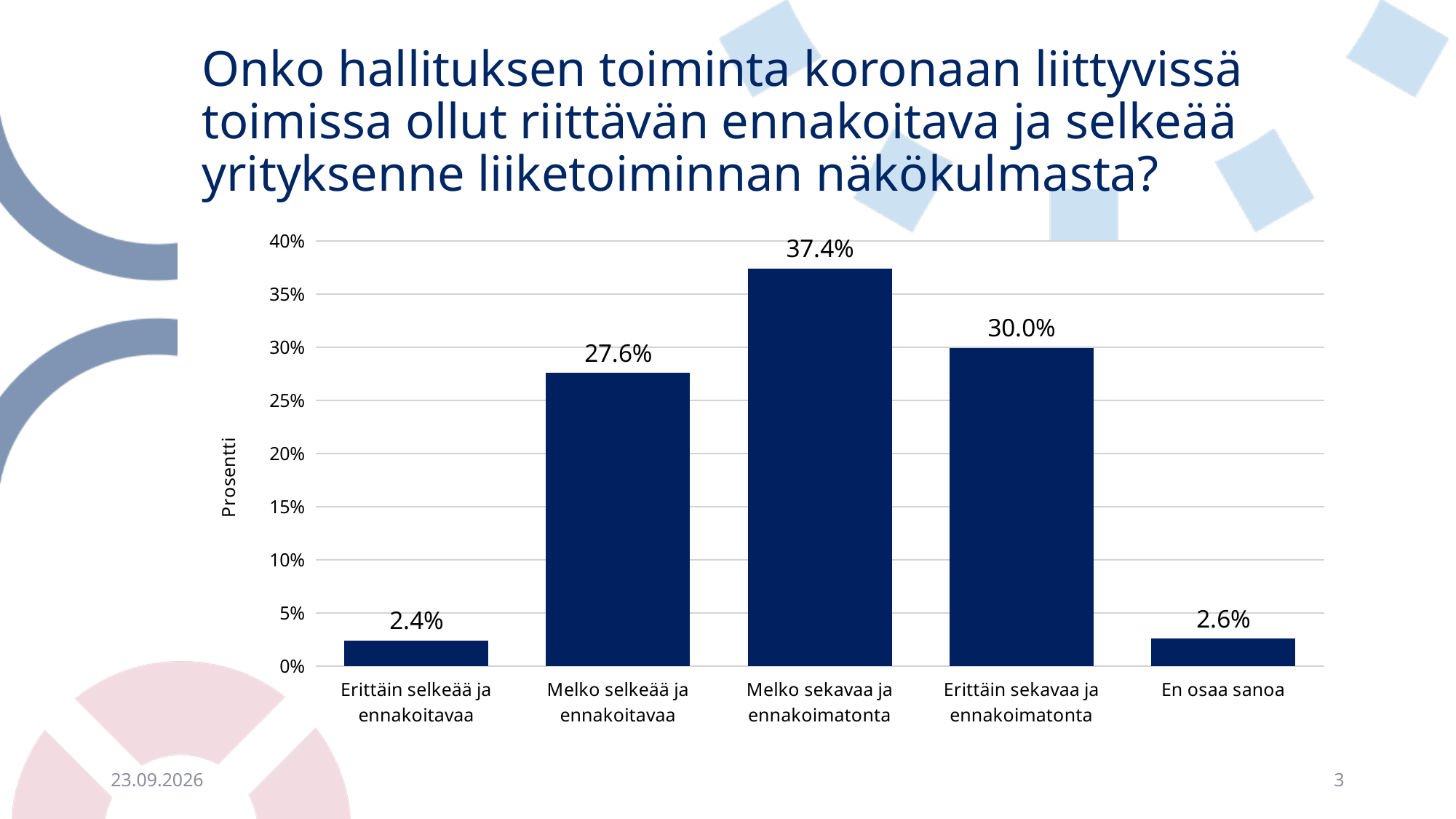
Which category has the lowest value? Erittäin selkeää ja ennakoitavaa What is the difference between "En osaa sanoa" and "Erittäin selkeää ja ennakoitavaa"? 0.2% What is the value for "En osaa sanoa"? 2.6% Which is larger, "Melko selkeää ja ennakoitavaa" or "Erittäin sekavaa ja ennakoimatonta"? Erittäin sekavaa ja ennakoimatonta How many categories are shown on the x axis? 5 What kind of chart is shown on the slide? Bar chart What is the value for "Erittäin selkeää ja ennakoitavaa"? 2.4% What is the label of the vertical axis? Prosentti Is the value for "Melko selkeää ja ennakoitavaa" greater or less than 25%? greater What is the difference between "Melko sekavaa ja ennakoimatonta" and "Erittäin sekavaa ja ennakoimatonta"? 7.4% What is the value for "Melko sekavaa ja ennakoimatonta"? 37.4% Which category has the highest value? Melko sekavaa ja ennakoimatonta